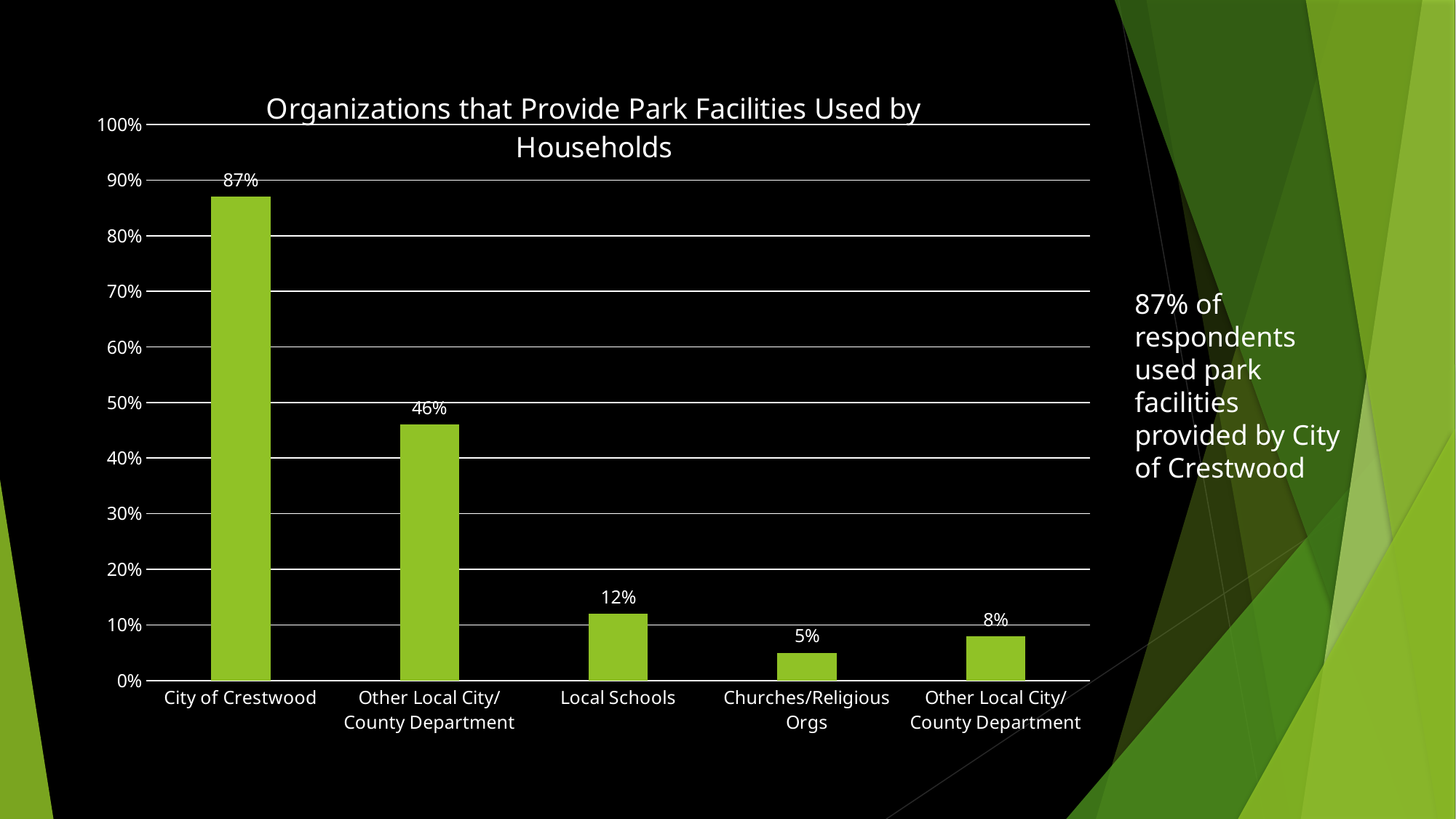
Which is larger, the value for Local Schools or the value for Churches/Religious Orgs? Local Schools What is the value of the second bar from the left, labelled Other Local City/County Department? 46% Which category has the lowest value? Churches/Religious Orgs What is the value of the last bar on the right, labelled Other Local City/County Department? 8% What is the difference between the value for City of Crestwood and the value for Local Schools? 75% What is the value for City of Crestwood? 87% What kind of chart is shown on the slide? Bar chart What is the title of the chart? Organizations that Provide Park Facilities Used by Households Which category has the highest value? City of Crestwood What is the value for Churches/Religious Orgs? 5% How many bars are shown in the chart? 5 What is the value for Local Schools? 12%